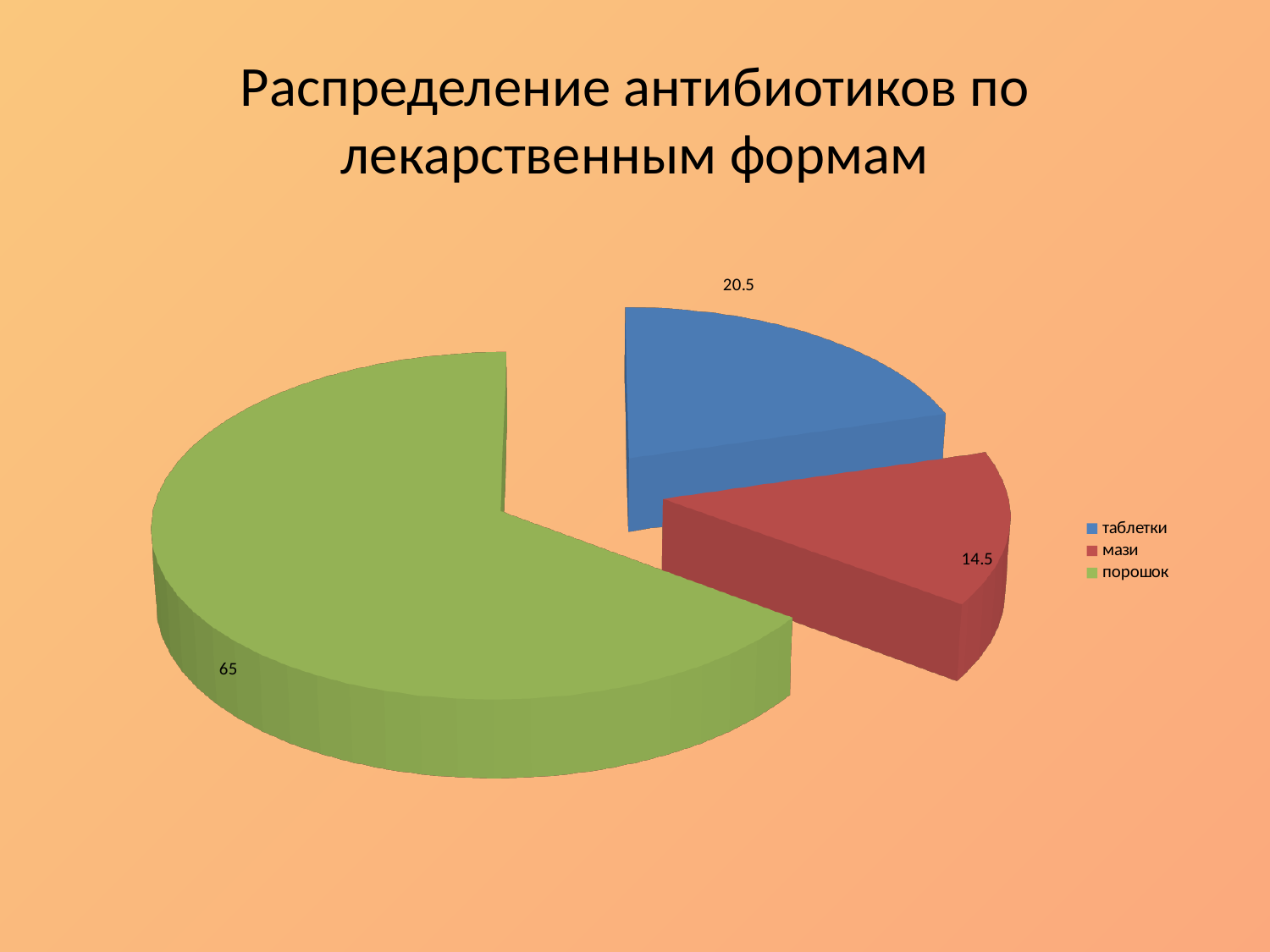
How many slices does the pie chart have? 3 Which is larger, the value for таблетки or the value for мази? таблетки Which category has the largest slice? порошок What is the value for мази? 14.5 What is the title of the chart? Распределение антибиотиков по лекарственным формам What type of chart is shown on the slide? pie chart What is the value for таблетки? 20.5 What is the difference between the values for таблетки and мази? 6 What is the difference between the values for порошок and таблетки? 44.5 What is the value for порошок? 65 What colour is the slice for порошок? green Which category has the smallest slice? мази